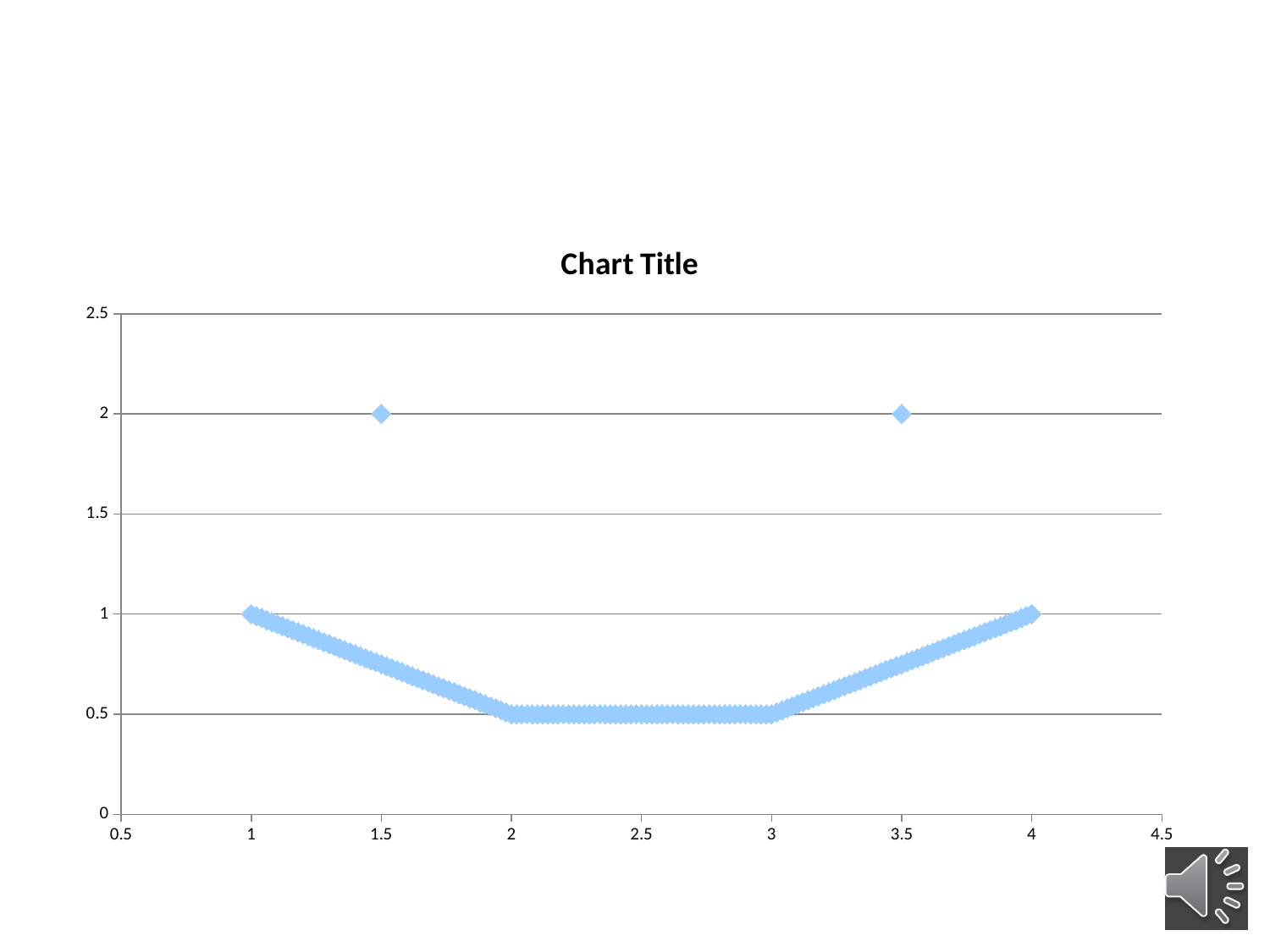
Is the y value at x = 2.5 greater or less than 1? less What kind of chart is shown on the slide? scatter chart Along the dense band of points, do the y values rise or fall from x = 3 to x = 4? rise Which has the larger y value, the point at x = 1.5 or the point at x = 1? the point at x = 1.5 What is the title of the chart? Chart Title What is the highest y value plotted on the chart? 2 What is the y value of the points at x = 2? 0.5 What is the y value of the point at x = 1? 1 What is the y value of the isolated point at x = 3.5? 2 What is the y value of the isolated point at x = 1.5? 2 What is the lowest y value plotted on the chart? 0.5 What is the y value of the point at x = 4? 1